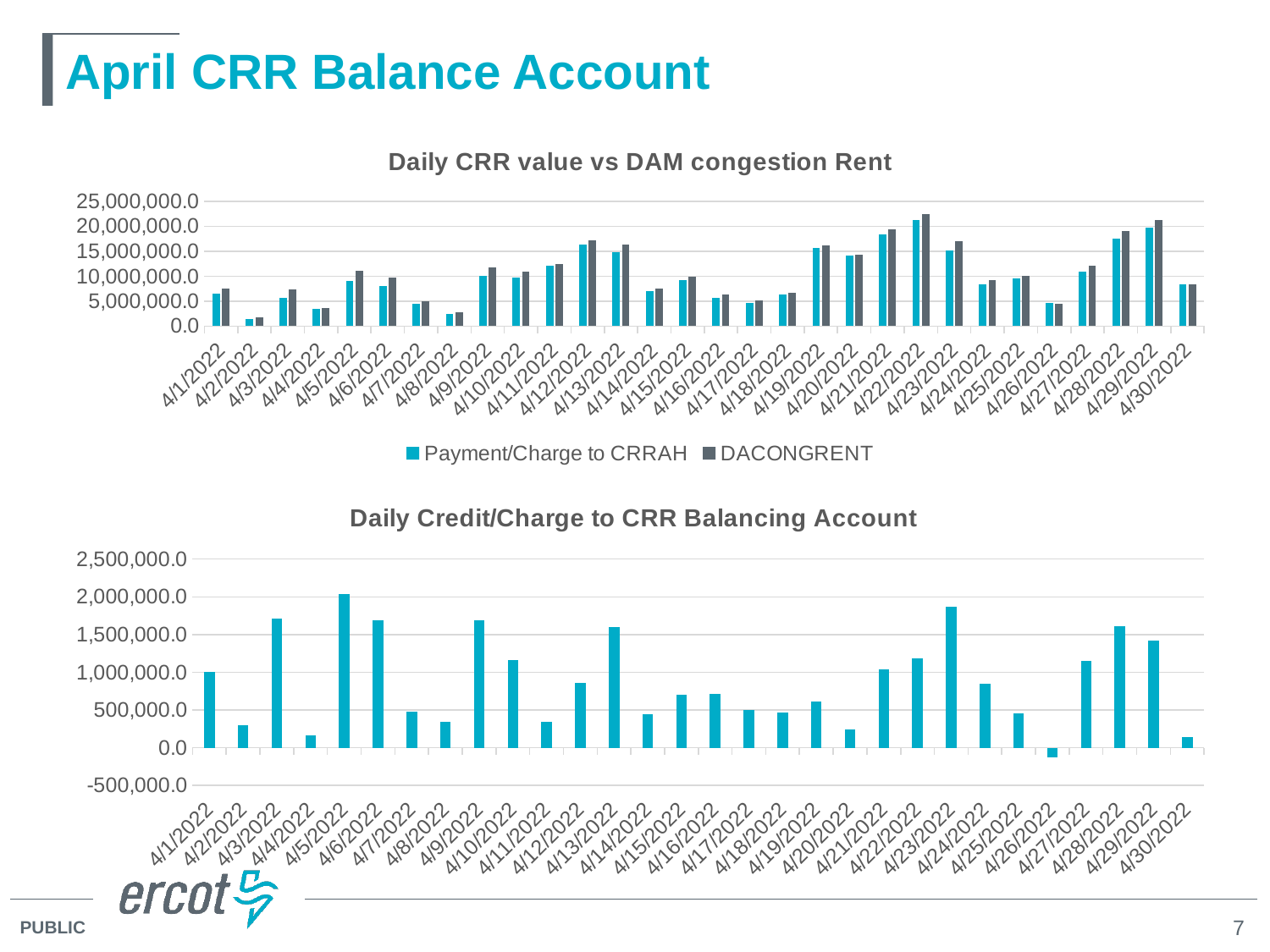
In the top chart, 'Daily CRR value vs DAM congestion Rent', on which date is the Payment/Charge to CRRAH value lowest? 4/2/2022 In the top chart, 'Daily CRR value vs DAM congestion Rent', is the Payment/Charge to CRRAH value for 4/2/2022 greater or less than 5,000,000.0? less In the bottom chart, 'Daily Credit/Charge to CRR Balancing Account', on which date is the value highest? 4/5/2022 In the bottom chart, 'Daily Credit/Charge to CRR Balancing Account', is the value for 4/3/2022 greater or less than 1,500,000.0? greater In the bottom chart, 'Daily Credit/Charge to CRR Balancing Account', how many dates are plotted on the x axis? 30 In the top chart, 'Daily CRR value vs DAM congestion Rent', is the DACONGRENT value for 4/22/2022 greater or less than 20,000,000.0? greater In the top chart, 'Daily CRR value vs DAM congestion Rent', what are the two series named in the legend? Payment/Charge to CRRAH and DACONGRENT In the bottom chart, 'Daily Credit/Charge to CRR Balancing Account', on which date is the value lowest (the only negative bar)? 4/26/2022 In the top chart, 'Daily CRR value vs DAM congestion Rent', on which date is the DACONGRENT value highest? 4/22/2022 What kind of chart is the bottom chart, 'Daily Credit/Charge to CRR Balancing Account'? bar chart In the top chart, 'Daily CRR value vs DAM congestion Rent', which is larger: the Payment/Charge to CRRAH value for 4/22/2022 or for 4/4/2022? 4/22/2022 In the top chart, 'Daily CRR value vs DAM congestion Rent', how many series does the legend list? 2